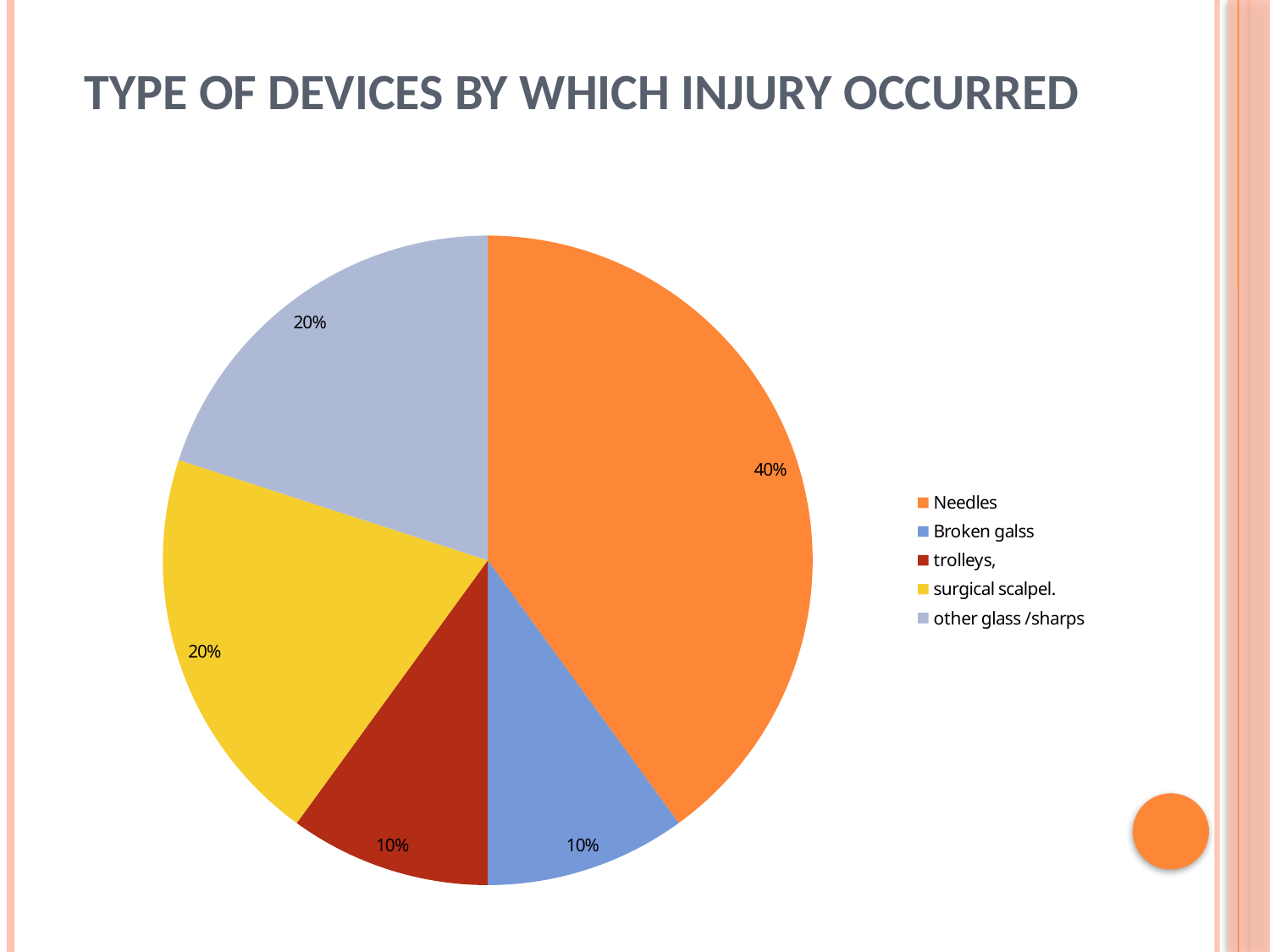
What share of injuries is attributed to Needles? 40% What colour is the slice for Needles? orange How many categories does the legend list? 5 Which device type accounts for the largest share of injuries? Needles What is the difference between the share for Needles and the share for surgical scalpel? 20% What type of chart is shown on the slide? pie chart What share of injuries is attributed to other glass /sharps? 20% What share of injuries is attributed to trolleys? 10% What share of injuries is attributed to surgical scalpel? 20% What share of injuries is attributed to Broken galss? 10% What is the title of the chart? TYPE OF DEVICES BY WHICH INJURY OCCURRED Which has a larger share, Needles or other glass /sharps? Needles